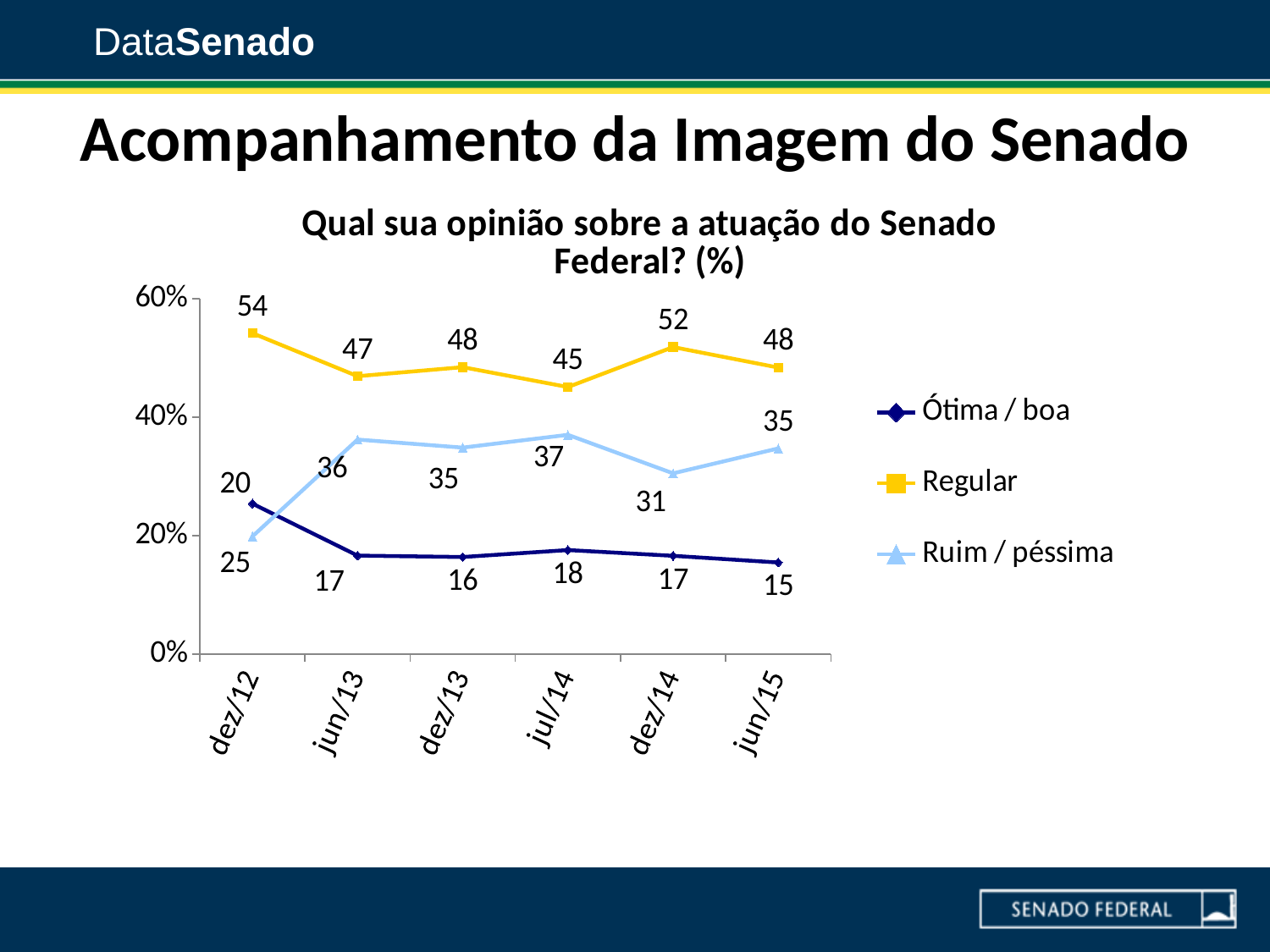
What kind of chart is shown on the slide? line chart How many series does the legend list? 3 What is the value for Ótima / boa in jun/15? 15 In which survey date is the Regular series highest? dez/12 In jun/13, which is larger: Regular or Ruim / péssima? Regular How many survey dates are plotted along the x axis? 6 What is the value for Ruim / péssima in dez/14? 31 Is the value for Regular in dez/12 greater or less than 40%? greater What is the difference between the Regular values in dez/14 and jun/15? 4 Does the Ótima / boa series rise or fall from dez/14 to jun/15? fall What is the value for Regular in dez/14? 52 In which survey date is the Regular series lowest? jul/14